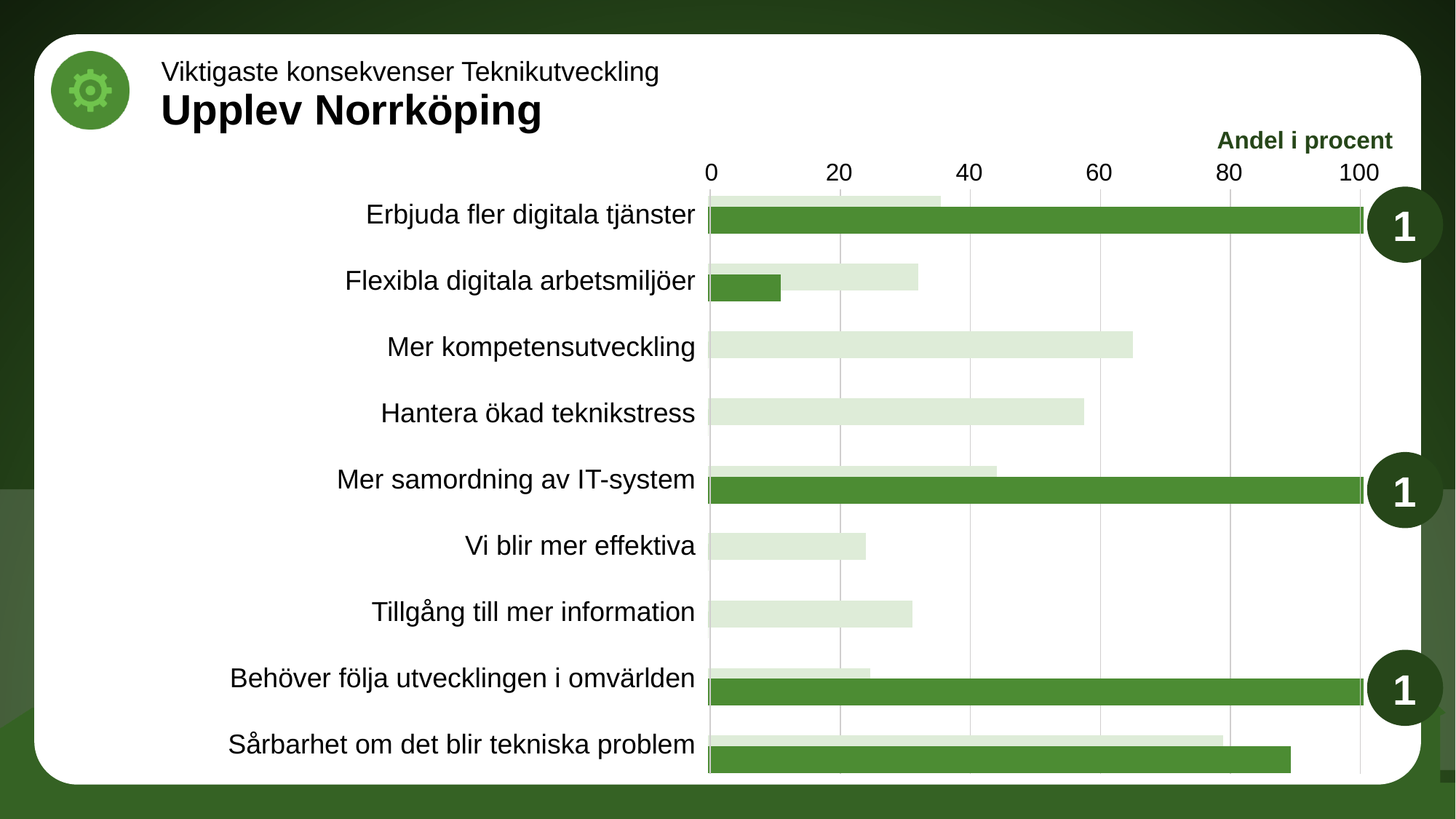
How many categories have a dark green bar? 5 Is the light green bar for 'Mer kompetensutveckling' greater or less than 60? greater Which category has the longest light green bar? Sårbarhet om det blir tekniska problem What kind of chart is shown on the slide? bar chart Is the light green bar for 'Hantera ökad teknikstress' greater or less than 60? less What value does the dark green bar for 'Mer samordning av IT-system' reach on the axis? 100 Which light green bar is longer: 'Mer kompetensutveckling' or 'Hantera ökad teknikstress'? Mer kompetensutveckling Is the dark green bar for 'Sårbarhet om det blir tekniska problem' greater or less than 80? greater How many categories are listed on the chart? 9 What is the label shown above the horizontal axis of the chart? Andel i procent What value does the dark green bar for 'Erbjuda fler digitala tjänster' reach on the axis? 100